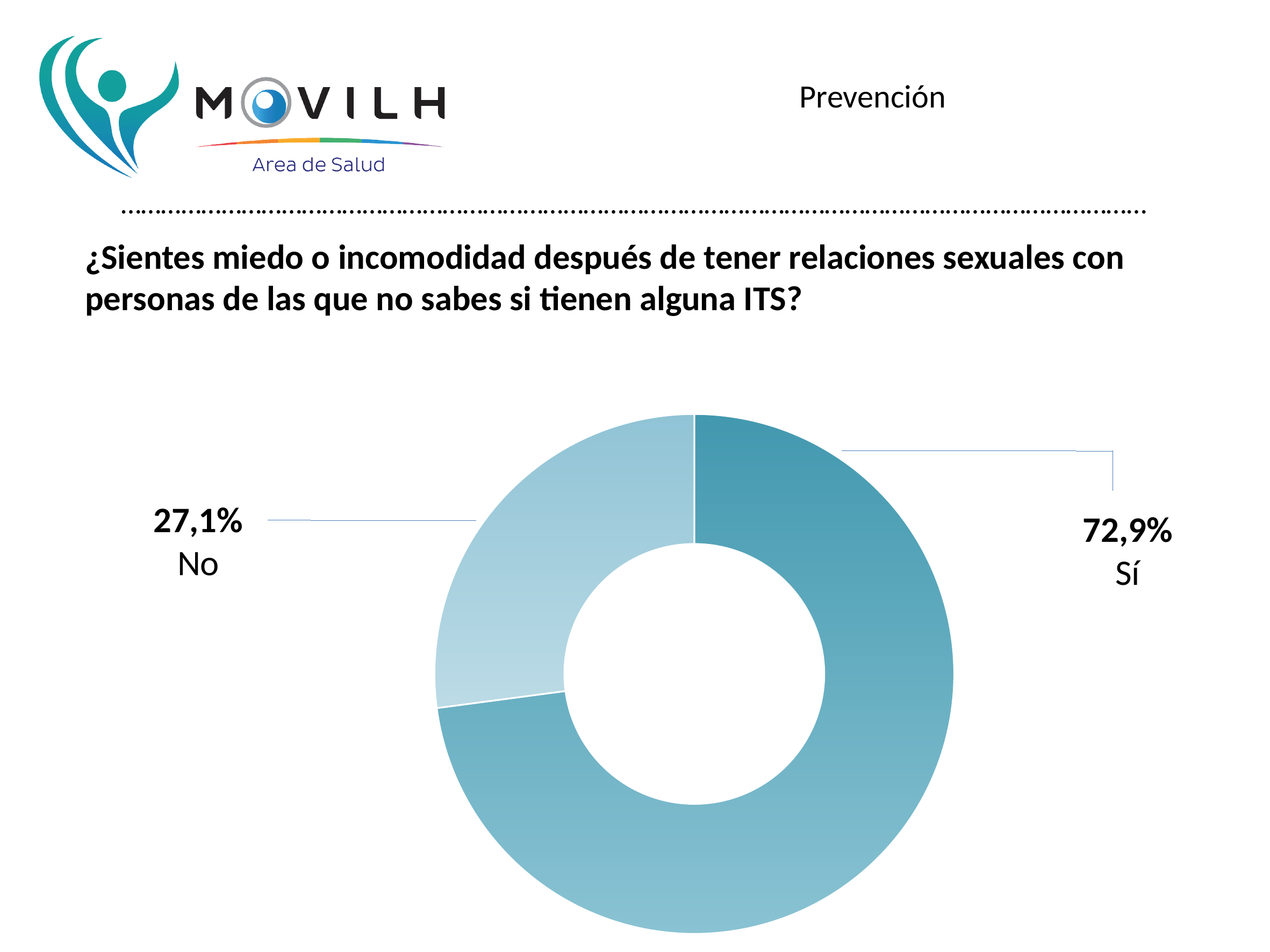
What share of the chart does the "Sí" slice represent? 72,9% Which response has the smallest share of the chart? No What percentage of respondents answered "Sí"? 72,9% Which response has the largest share of the chart? Sí Is the share for "Sí" greater or less than 50%? greater What question does the chart on the slide present results for? ¿Sientes miedo o incomodidad después de tener relaciones sexuales con personas de las que no sabes si tienen alguna ITS? What percentage of respondents answered "No"? 27,1% How many categories are shown in the chart? 2 What kind of chart is shown on the slide? Doughnut (pie) chart What is the difference in percentage points between the "Sí" and "No" shares? 45,8 Which is larger, the share for "Sí" or the share for "No"? Sí What section label appears at the top right of the slide? Prevención